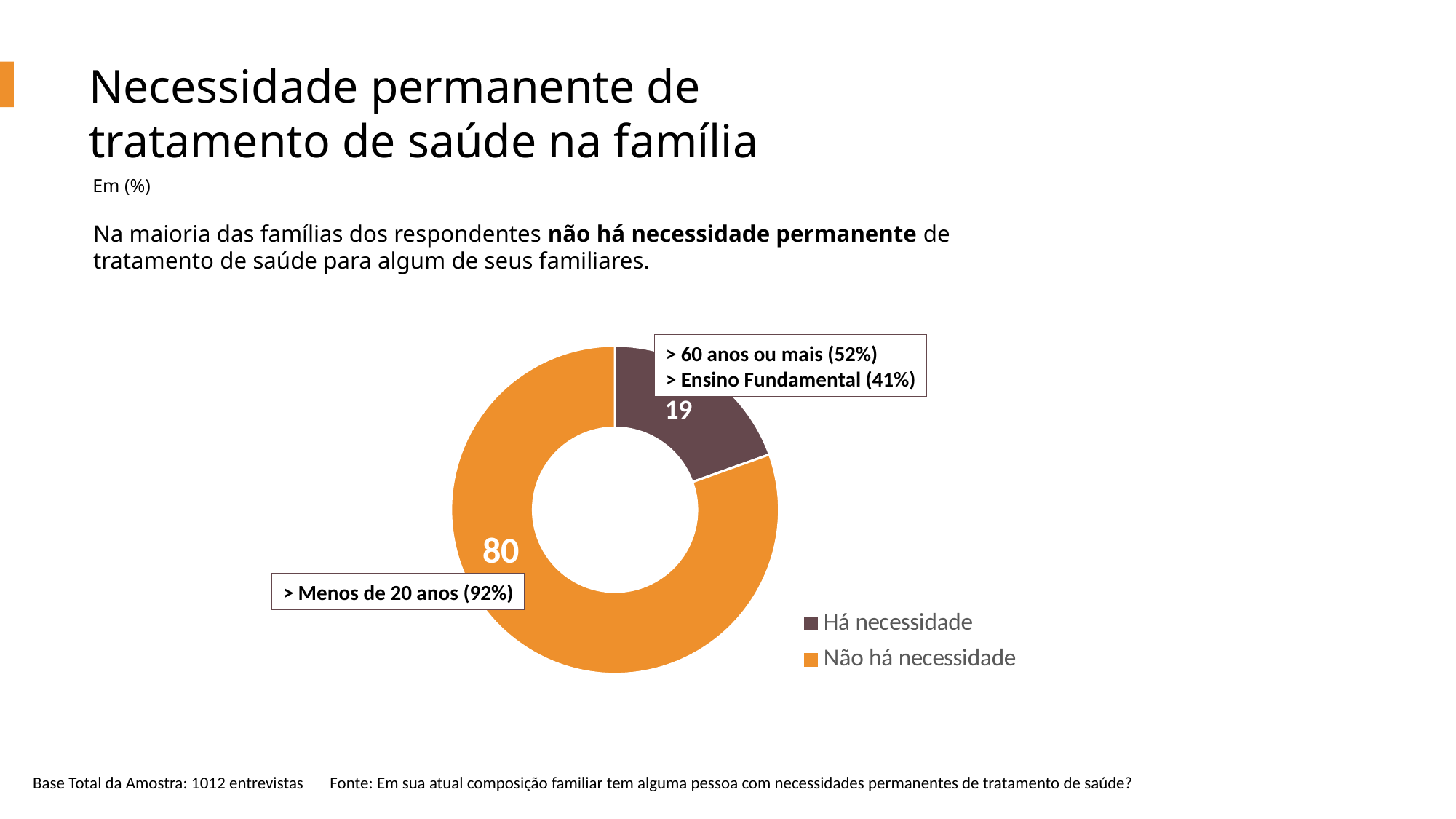
According to the callout box, what percentage is given for "Menos de 20 anos"? 92% What kind of chart is shown on the slide? Donut (pie) chart What is the base total of the sample stated at the bottom of the slide? 1012 entrevistas What value is shown for "Não há necessidade"? 80 How many entries does the chart legend list? 2 Which is larger, the value for "Há necessidade" or the value for "Não há necessidade"? Não há necessidade What colour is the "Não há necessidade" slice? Orange What value is shown for "Há necessidade"? 19 Which category has the largest slice of the donut chart? Não há necessidade Which category has the smallest labelled slice of the donut chart? Há necessidade According to the callout box, what percentage is given for "60 anos ou mais"? 52% What is the difference between the values for "Não há necessidade" and "Há necessidade"? 61